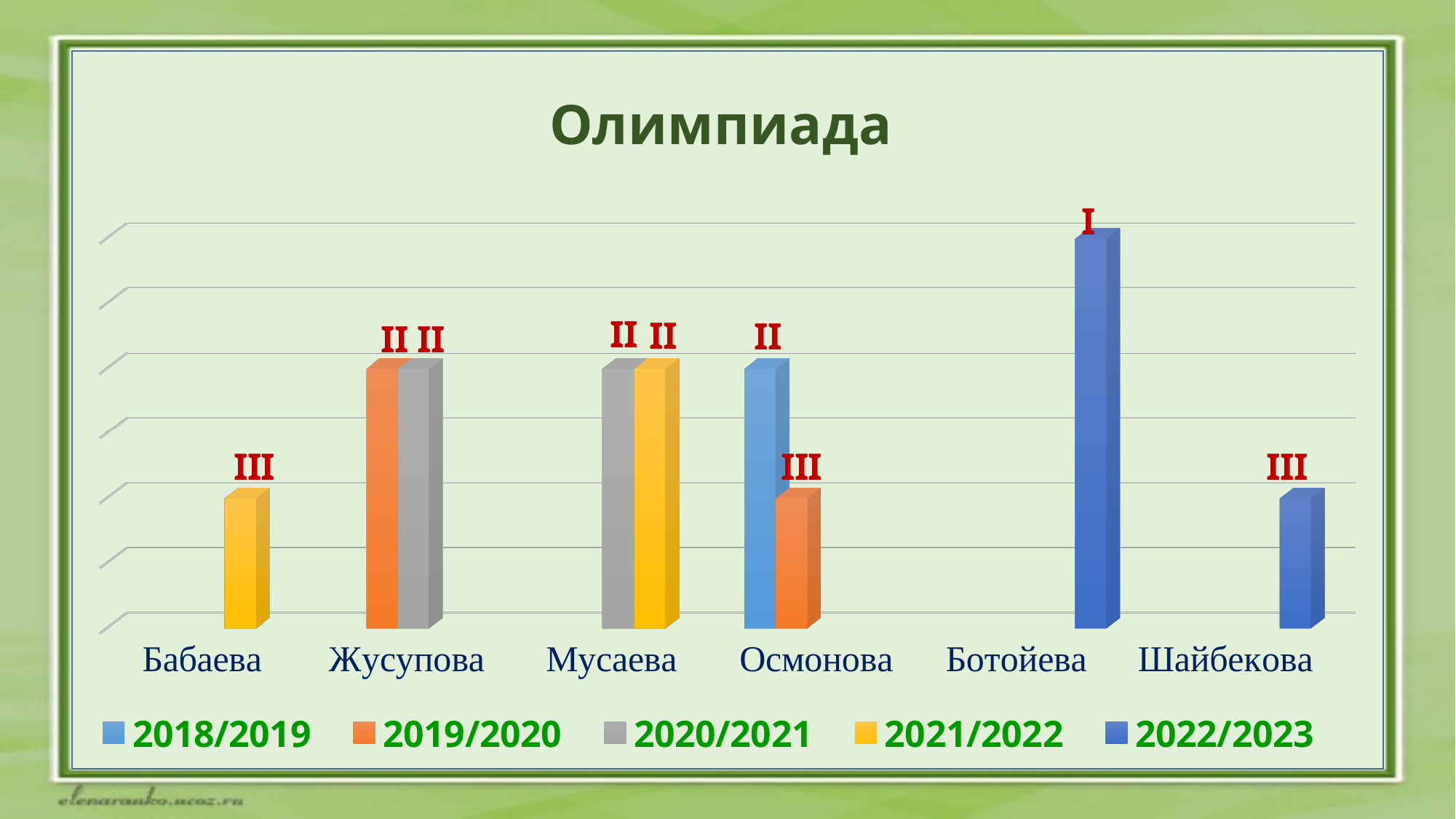
How many series does the legend of the chart list? 5 What label is printed above the 2022/2023 bar for Ботойева? I What label is printed above the 2018/2019 bar for Осмонова? II Which category has the tallest bar in the chart? Ботойева What kind of chart is shown on the slide? bar chart What label is printed above the bar for Шайбекова? III What label is printed above the bar for Бабаева? III Which series in the legend is shown in yellow? 2021/2022 What label is printed above the 2019/2020 bar for Осмонова? III What is the title of the chart? Олимпиада Which bar is taller: the one for Ботойева or the one for Шайбекова? Ботойева How many categories (names) are shown along the x axis of the chart? 6